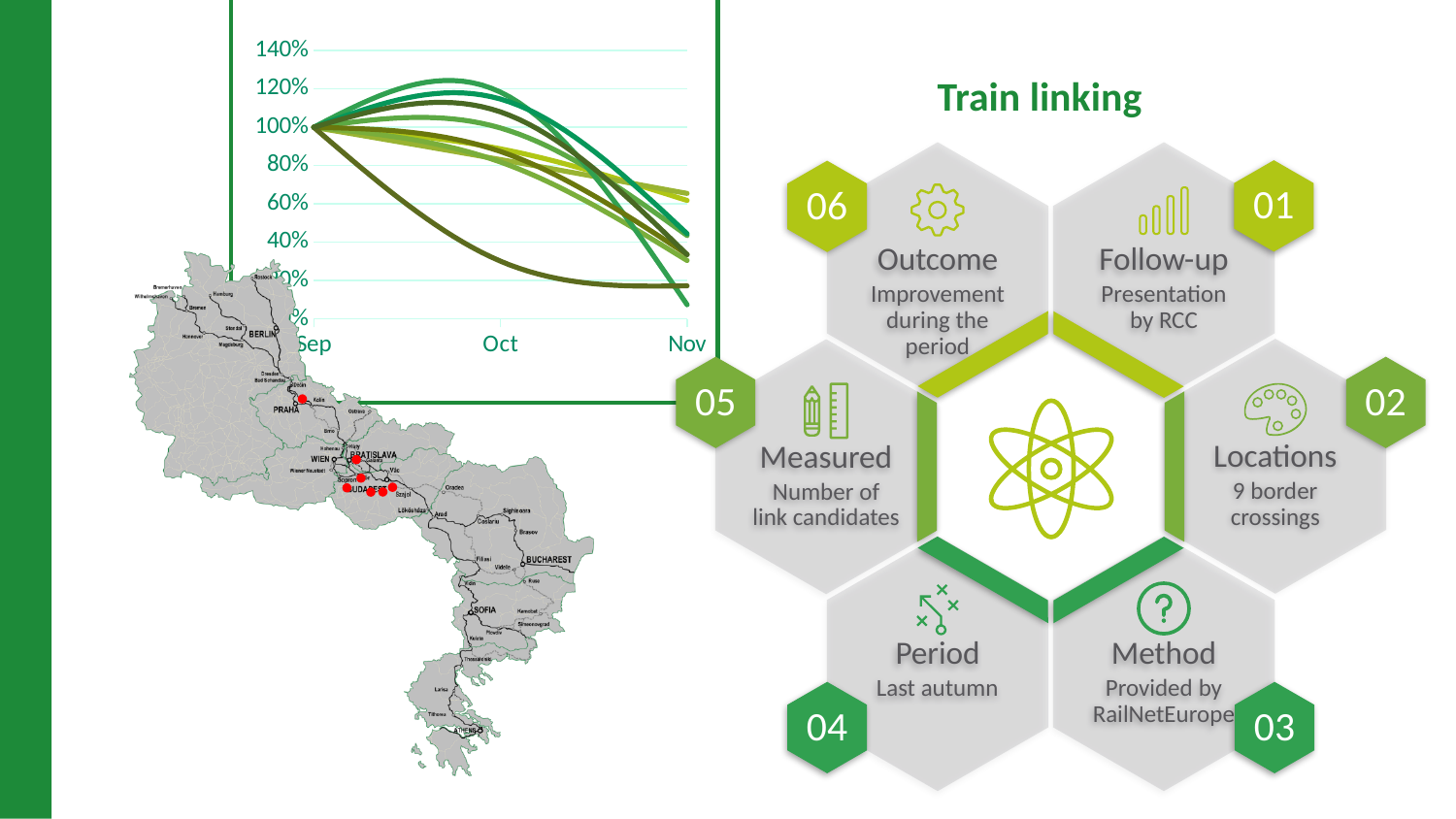
Which month on the x axis has the lowest values for the lines, Sep or Nov? Nov How many months are labelled on the x axis of the line chart? 3 Which months are labelled on the x axis of the line chart? Sep, Oct, Nov Is the highest line's value in Nov greater or less than 40%? greater What kind of chart is shown on the slide? line chart Overall, do the lines rise or fall from Sep to Nov? fall Is the lowest line's value in Nov greater or less than 40%? less What is the highest value labelled on the y axis of the line chart? 140% Is the highest value reached by any line around Oct greater or less than 140%? less At what value do all the lines start in Sep? 100%